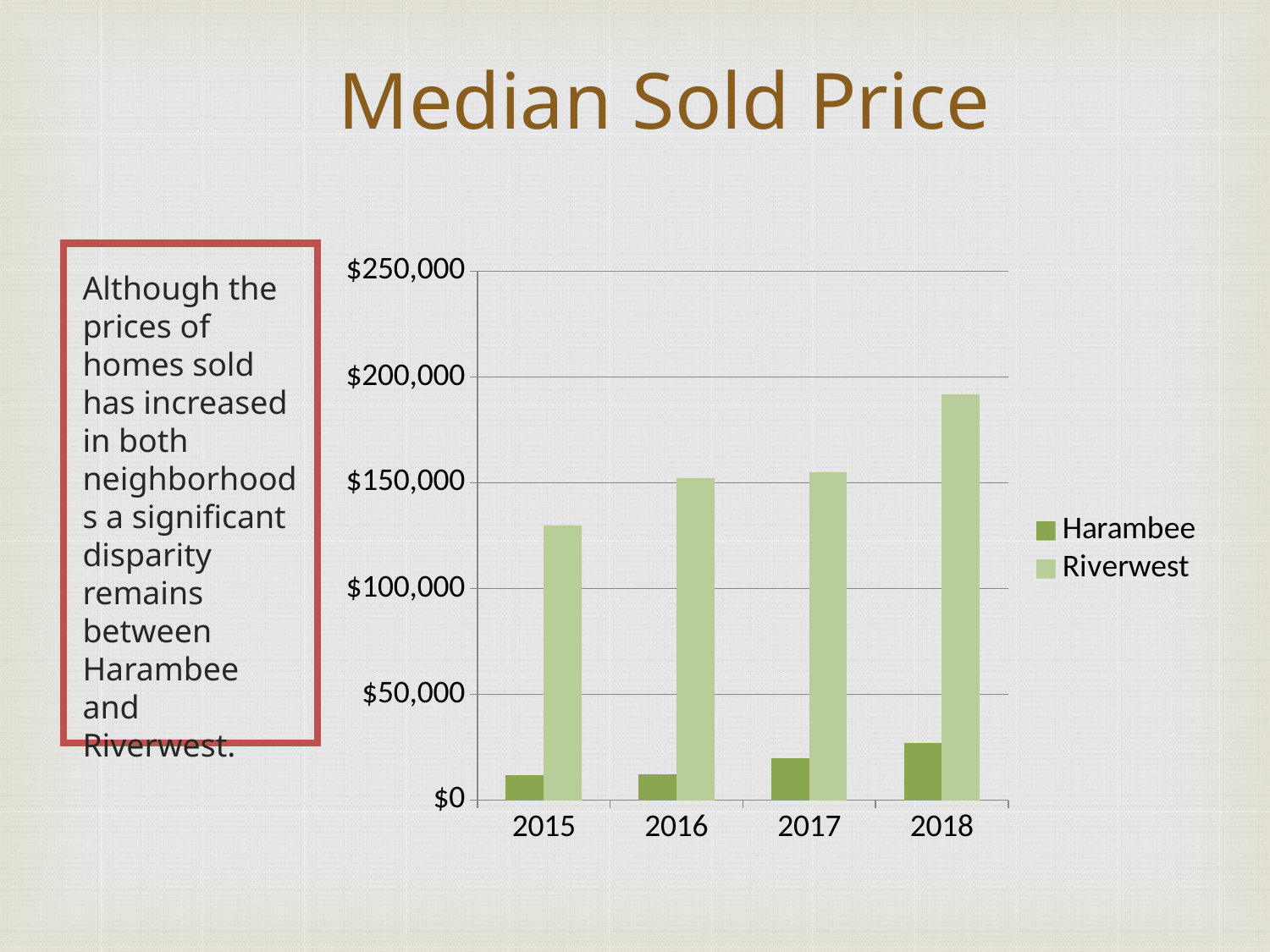
What is the title of the chart? Median Sold Price Is the value for Riverwest in 2018 greater or less than $150,000? greater Do the Riverwest values rise or fall from 2015 to 2018? rise In which year is the Harambee median sold price highest? 2018 How many series does the legend list? 2 Is the value for Riverwest in 2015 greater or less than $150,000? less How many years are shown on the x axis? 4 In which year is the Riverwest median sold price highest? 2018 Is the value for Harambee in 2018 greater or less than $50,000? less What kind of chart is shown on the slide? bar chart Which is larger in 2017, the Harambee value or the Riverwest value? Riverwest In which year is the Riverwest median sold price lowest? 2015